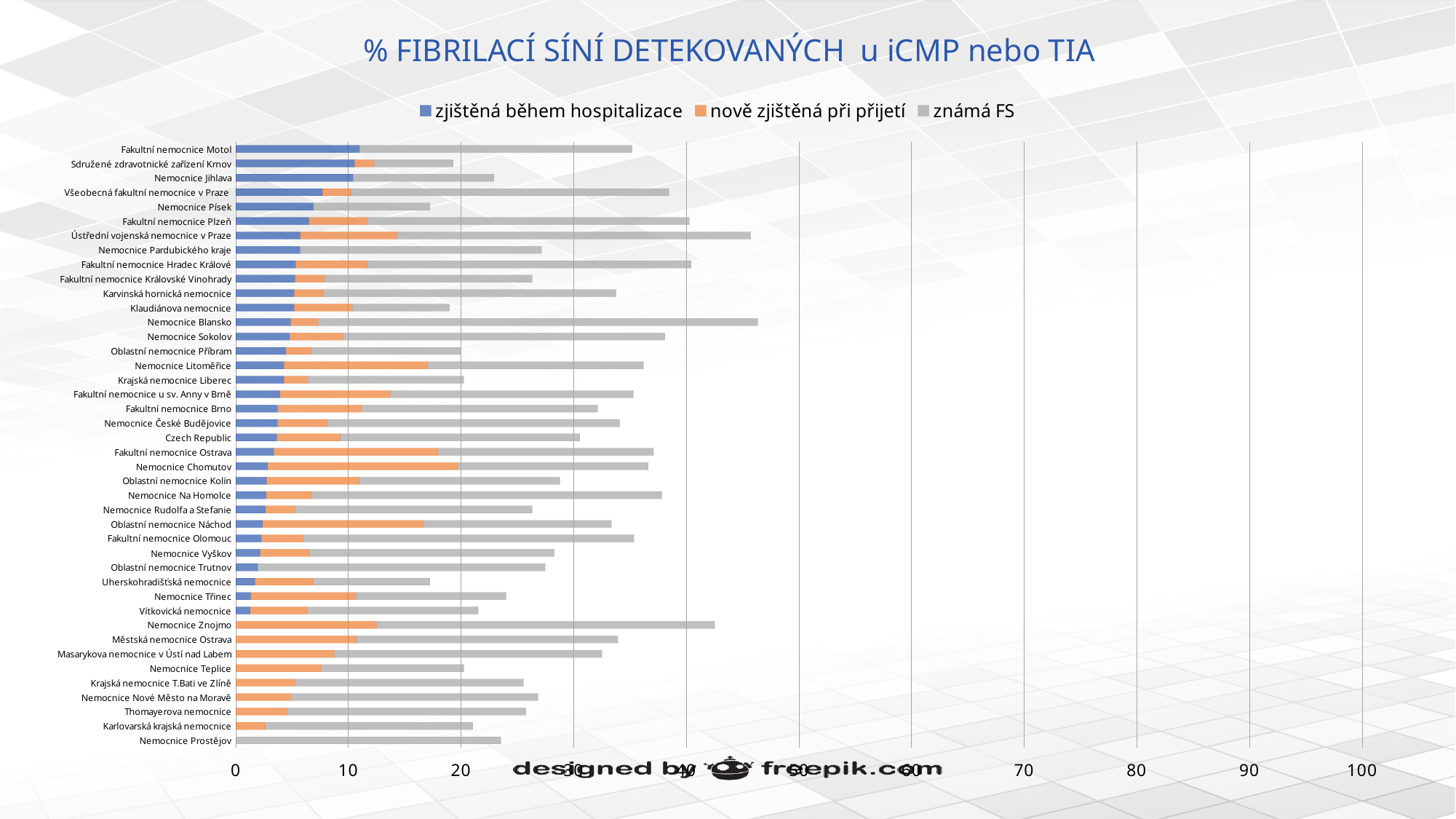
Which has the larger total bar, Nemocnice Znojmo or Nemocnice Teplice? Nemocnice Znojmo Is the total value for Nemocnice Znojmo greater or less than 40? greater Which has the larger total bar, Fakultní nemocnice Plzeň or Uherskohradišťská nemocnice? Fakultní nemocnice Plzeň How many series does the legend list? 3 What is the title of the chart? % FIBRILACÍ SÍNÍ DETEKOVANÝCH u iCMP nebo TIA Is the total value for Nemocnice Písek greater or less than 20? less What kind of chart is shown on the slide? bar chart Is the total value for Nemocnice Prostějov greater or less than 20? greater How many hospitals (categories) are plotted on the chart? 42 Which series is shown in grey in the legend? známá FS